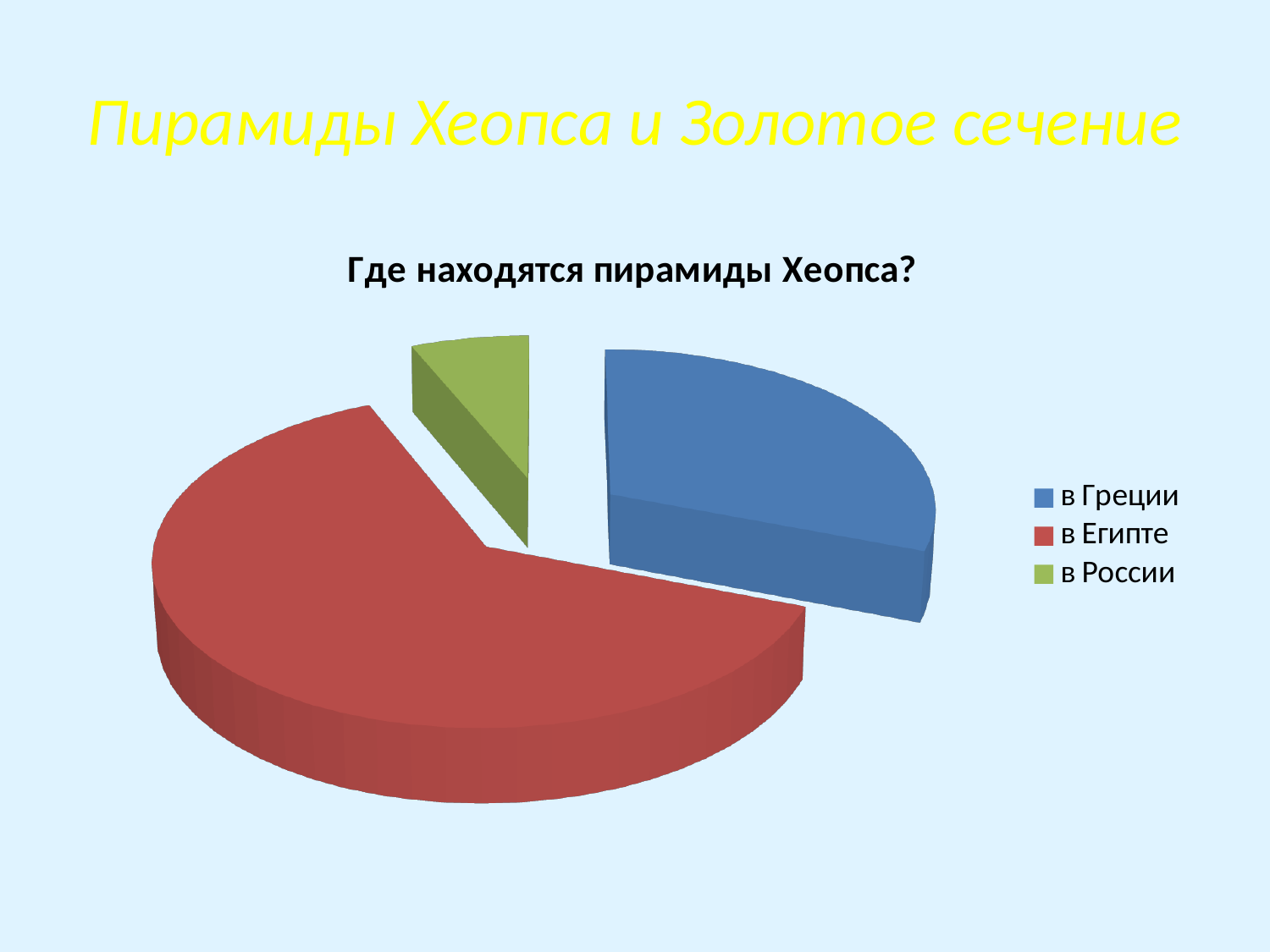
How many slices does the pie chart have? 3 Which category is shown in red? в Египте Which slice is larger, в Египте or в Греции? в Египте What kind of chart is shown on the slide? pie chart Which category has the smallest slice of the pie? в России Which slice is larger, в Греции or в России? в Греции What is the title of the chart? Где находятся пирамиды Хеопса? How many entries does the legend list? 3 Which category has the largest slice of the pie? в Египте